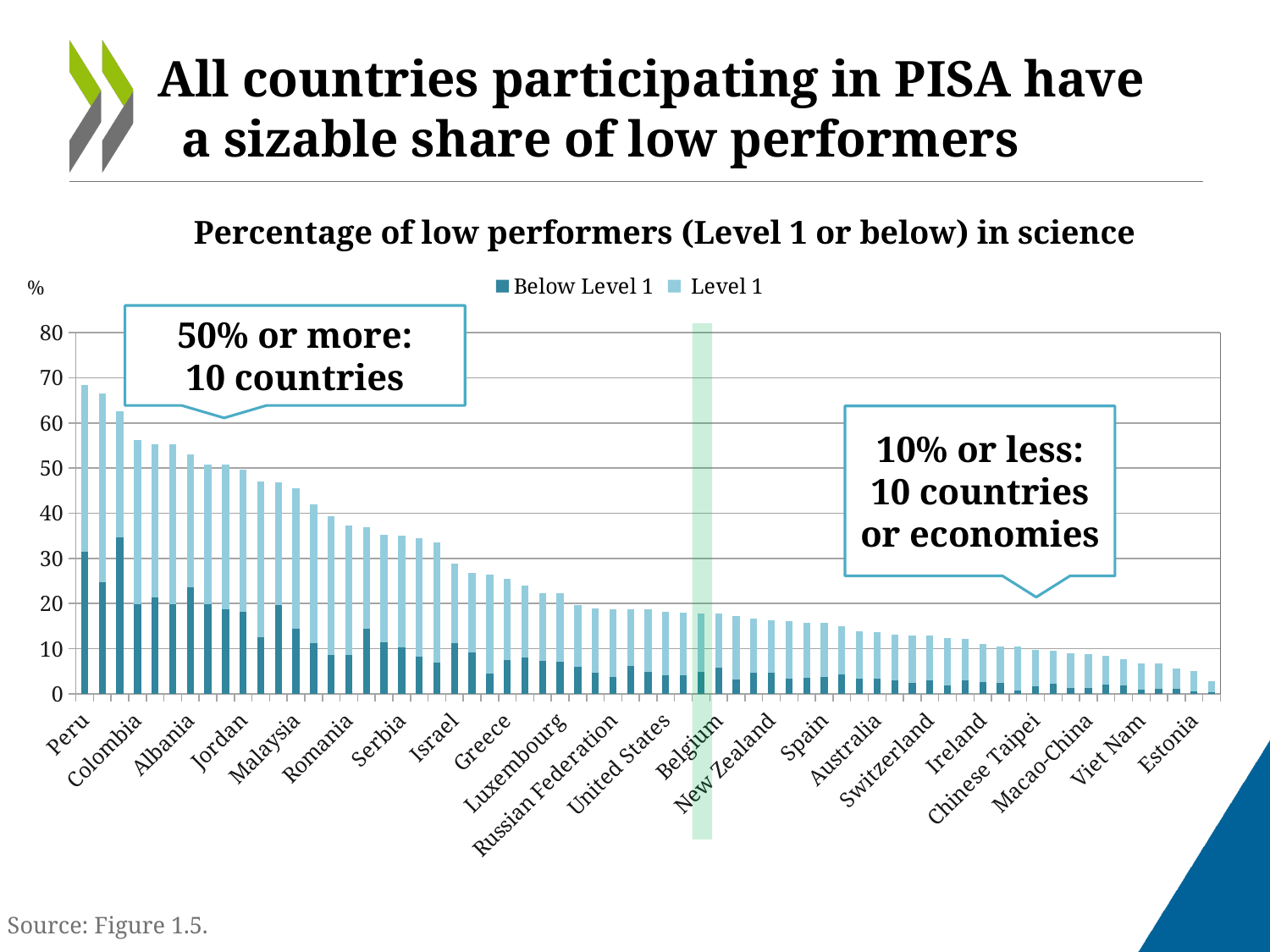
Do the total percentages of low performers rise or fall moving from left to right along the x axis? Fall What kind of chart is shown on the slide? Stacked bar chart Is the total percentage of low performers for Estonia greater or less than 10? less Is the total percentage of low performers for Peru greater or less than 60? greater Is the total percentage of low performers for Colombia greater or less than 50? greater What is the title of the chart? Percentage of low performers (Level 1 or below) in science Which country has the highest percentage of low performers in science? Peru What are the two series named in the legend? Below Level 1 and Level 1 Which has a larger total percentage of low performers, Jordan or Ireland? Jordan How many series does the legend list? 2